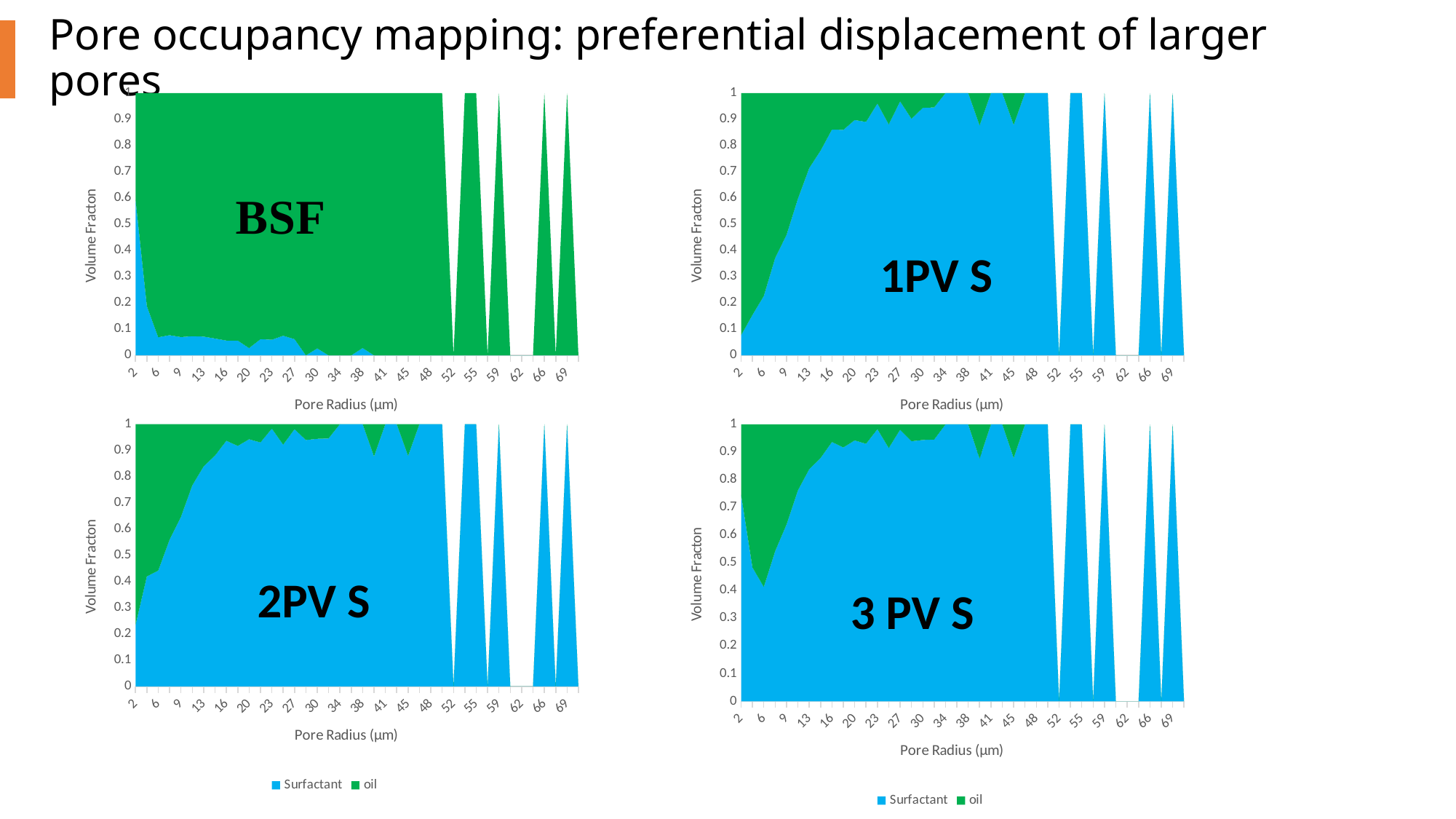
What are the two series named in the legend of the 3 PV S chart? Surfactant and oil In the 1PV S chart, does the Surfactant volume fraction rise or fall as pore radius increases from 2 to 20? rise How many series does the legend list for the 2PV S chart? 2 What is the x-axis label on the 1PV S chart? Pore Radius (µm) In the 3 PV S chart, at pore radius 30, which series has the larger volume fraction, Surfactant or oil? Surfactant How many charts are shown on the slide? 4 In the 3 PV S chart, is the Surfactant volume fraction at pore radius 6 greater or less than 0.7? less In the 1PV S chart, is the Surfactant volume fraction at pore radius 30 greater or less than 0.8? greater What kind of chart is the BSF chart? stacked area chart In the 2PV S chart, is the Surfactant volume fraction at pore radius 2 greater or less than 0.5? less